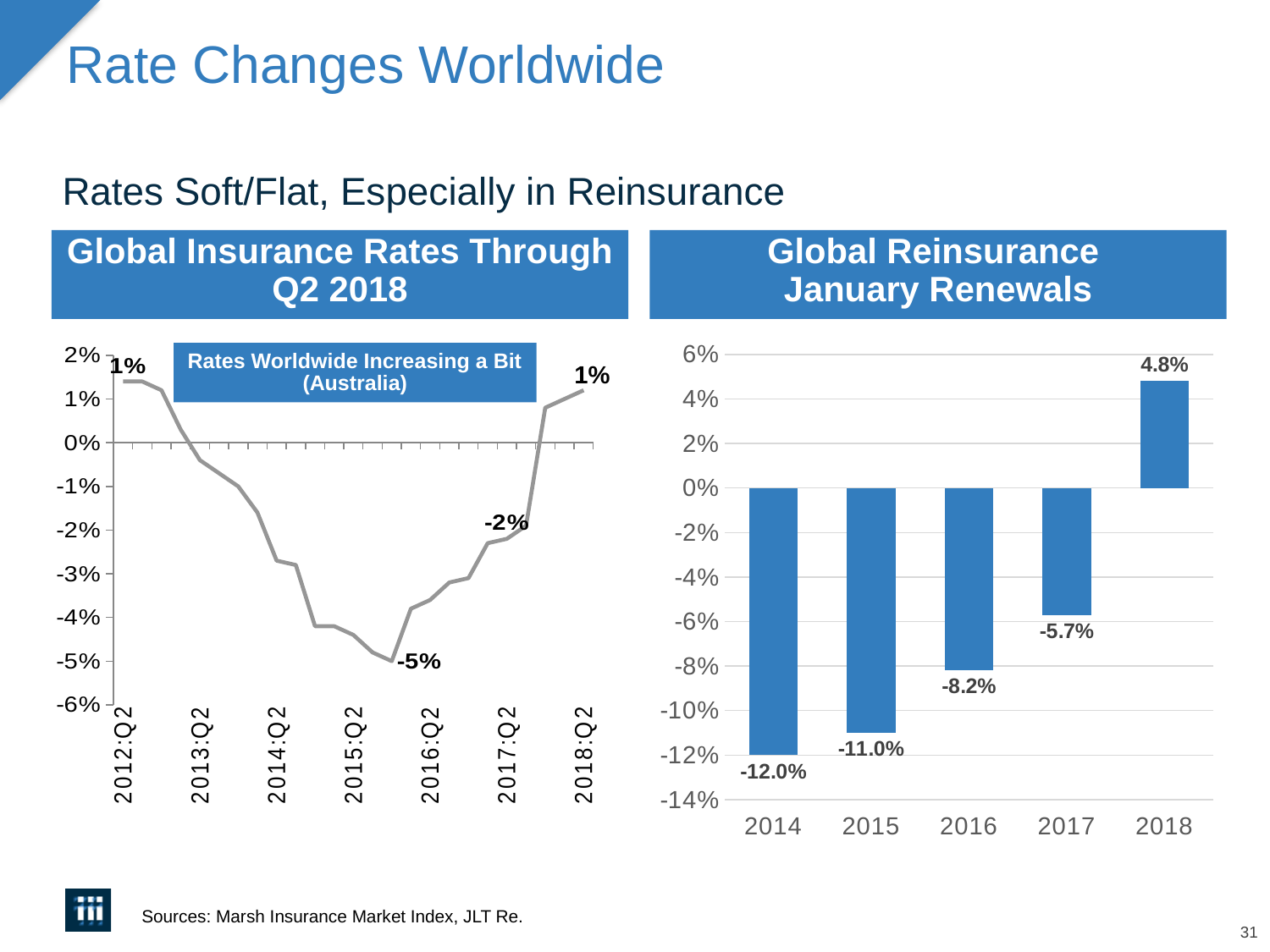
In the Global Reinsurance January Renewals chart, what is the value for 2018? 4.8% In the Global Reinsurance January Renewals chart, which year has the lowest value? 2014 What kind of chart is the Global Insurance Rates Through Q2 2018 chart? Line chart In the Global Reinsurance January Renewals chart, what is the difference between the 2017 and 2016 values? 2.5 percentage points What kind of chart is the Global Reinsurance January Renewals chart? Bar chart In the Global Reinsurance January Renewals chart, which is larger, the value for 2016 or the value for 2017? 2017 In the Global Insurance Rates Through Q2 2018 chart, is the value at 2014:Q2 greater or less than -2%? less In the Global Insurance Rates Through Q2 2018 chart, what is the labeled value at 2012:Q2? 1% How many years are shown in the Global Reinsurance January Renewals chart? 5 In the Global Reinsurance January Renewals chart, which year has the highest value? 2018 In the Global Reinsurance January Renewals chart, do the values rise or fall from 2014 to 2018? Rise In the Global Reinsurance January Renewals chart, what is the value for 2014? -12.0%